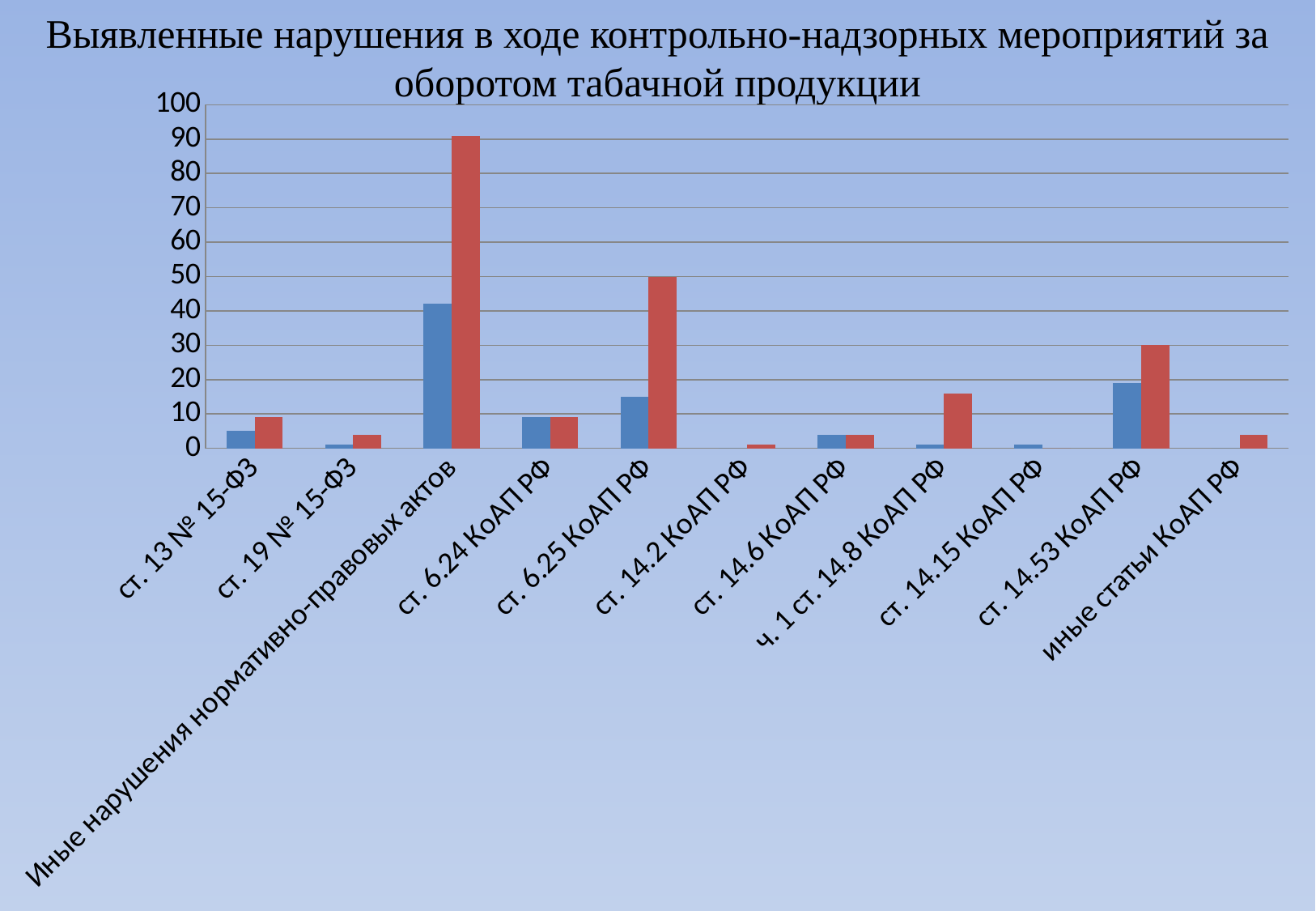
Which category has the tallest red bar? Иные нарушения нормативно-правовых актов How many data series (bar colours) are plotted in the chart? 2 Is the red bar for 'ч. 1 ст. 14.8 КоАП РФ' greater or less than 20? less How many categories are shown along the x axis of the chart? 11 Which has the taller blue bar: 'Иные нарушения нормативно-правовых актов' or 'ст. 6.25 КоАП РФ'? Иные нарушения нормативно-правовых актов Is the blue bar for 'Иные нарушения нормативно-правовых актов' greater or less than 30? greater Is the red bar for 'ст. 14.53 КоАП РФ' greater or less than 20? greater For 'ч. 1 ст. 14.8 КоАП РФ', which bar is taller, the blue one or the red one? The red one Which has the taller red bar: 'ст. 6.25 КоАП РФ' or 'ст. 14.53 КоАП РФ'? ст. 6.25 КоАП РФ What type of chart is shown on the slide? Bar chart